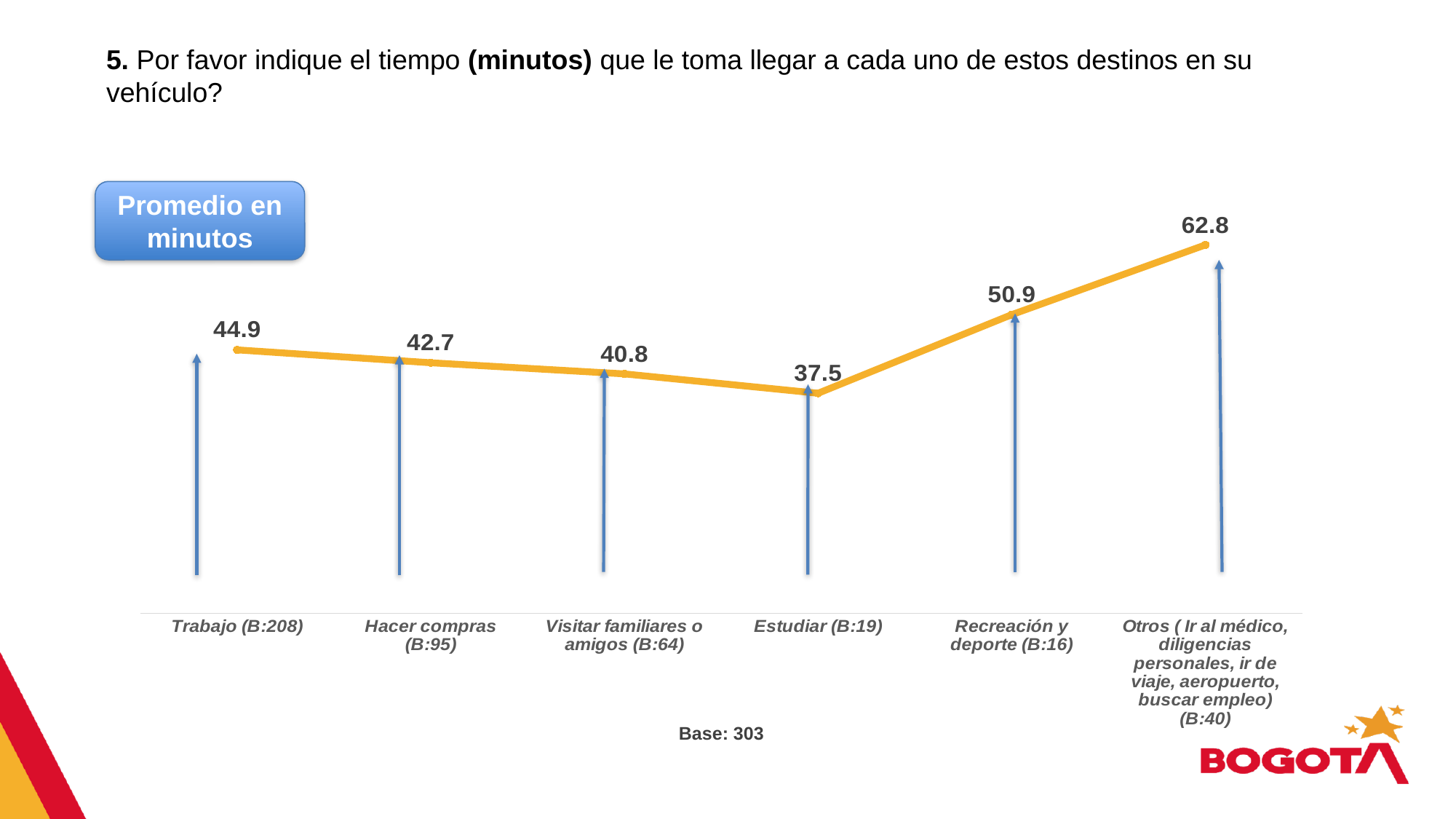
What is the average time in minutes to get to Trabajo (B:208)? 44.9 What kind of chart is shown on the slide? Line chart What is the difference in average minutes between Otros (B:40) and Estudiar (B:19)? 25.3 What is the average time in minutes for Recreación y deporte (B:16)? 50.9 What is the total base shown below the chart? 303 What is the average time in minutes for Hacer compras (B:95)? 42.7 What is the difference in average minutes between Trabajo (B:208) and Visitar familiares o amigos (B:64)? 4.1 How many destinations are plotted on the chart? 6 Which destination has the highest average time in minutes? Otros (B:40) Which destination has the lowest average time in minutes? Estudiar (B:19) What is the average time in minutes for Estudiar (B:19)? 37.5 Which has a higher average time: Hacer compras (B:95) or Recreación y deporte (B:16)? Recreación y deporte (B:16)